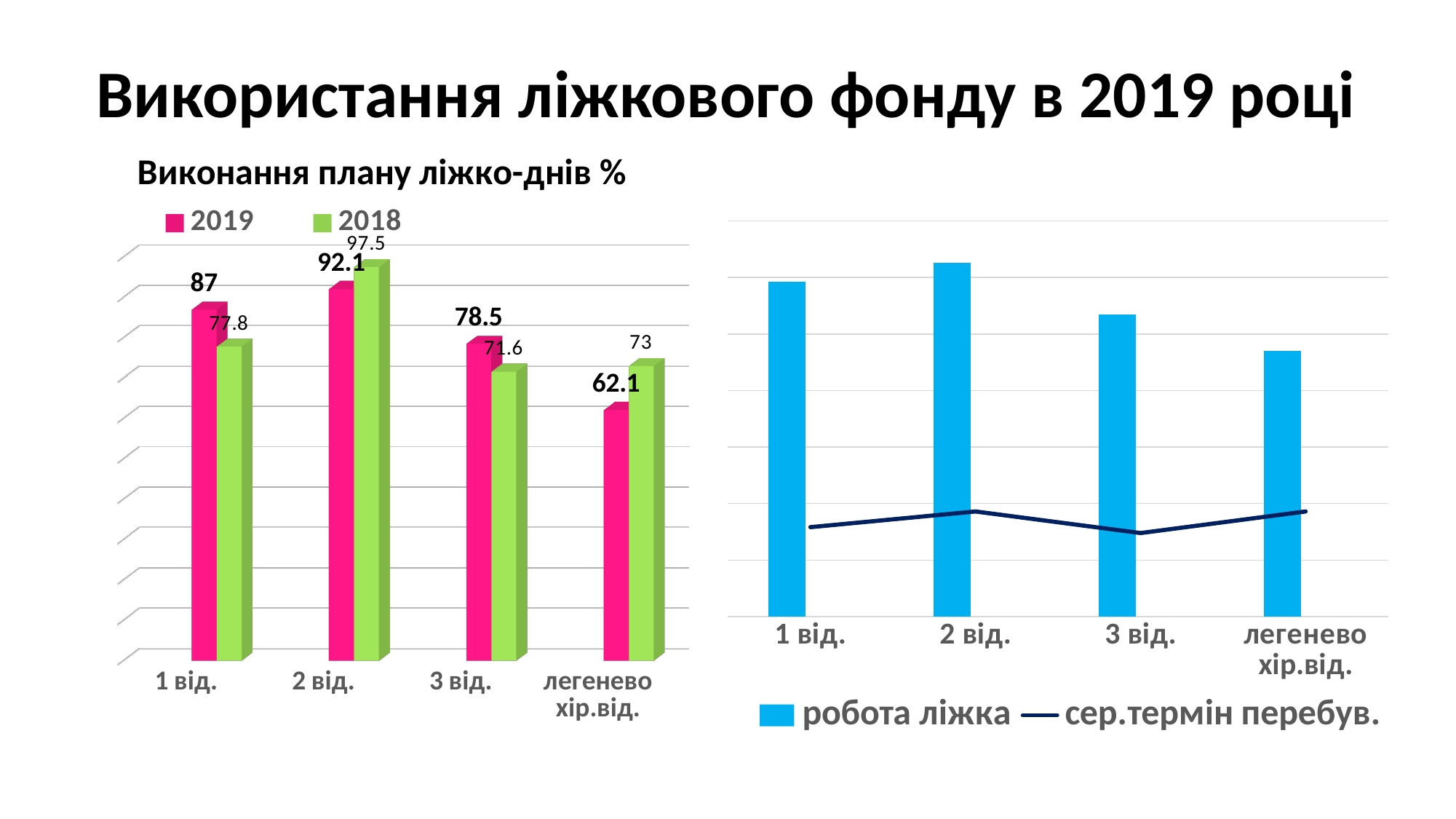
In the chart on the right of the slide, which category has the highest bar for 'робота ліжка'? 2 від. In the chart titled 'Виконання плану ліжко-днів %', which is larger for '1 від.': the 2019 value or the 2018 value? 2019 In the chart titled 'Виконання плану ліжко-днів %', which category has the lowest 2018 value? 3 від. In the chart titled 'Виконання плану ліжко-днів %', what is the 2018 value for '2 від.'? 97.5 In the chart on the right of the slide, which category has the lowest bar for 'робота ліжка'? легенево хір.від. In the chart titled 'Виконання плану ліжко-днів %', what is the 2019 value for 'легенево хір.від.'? 62.1 In the chart titled 'Виконання плану ліжко-днів %', what is the difference between the 2019 and 2018 values for '3 від.'? 6.9 In the chart titled 'Виконання плану ліжко-днів %', what is the 2019 value for '1 від.'? 87 In the chart titled 'Виконання плану ліжко-днів %', how many series does the legend list? 2 In the chart on the right of the slide, what are the two legend entries? робота ліжка; сер.термін перебув. In the chart on the right of the slide, how many categories are shown on the x axis? 4 In the chart titled 'Виконання плану ліжко-днів %', which category has the highest 2019 value? 2 від.